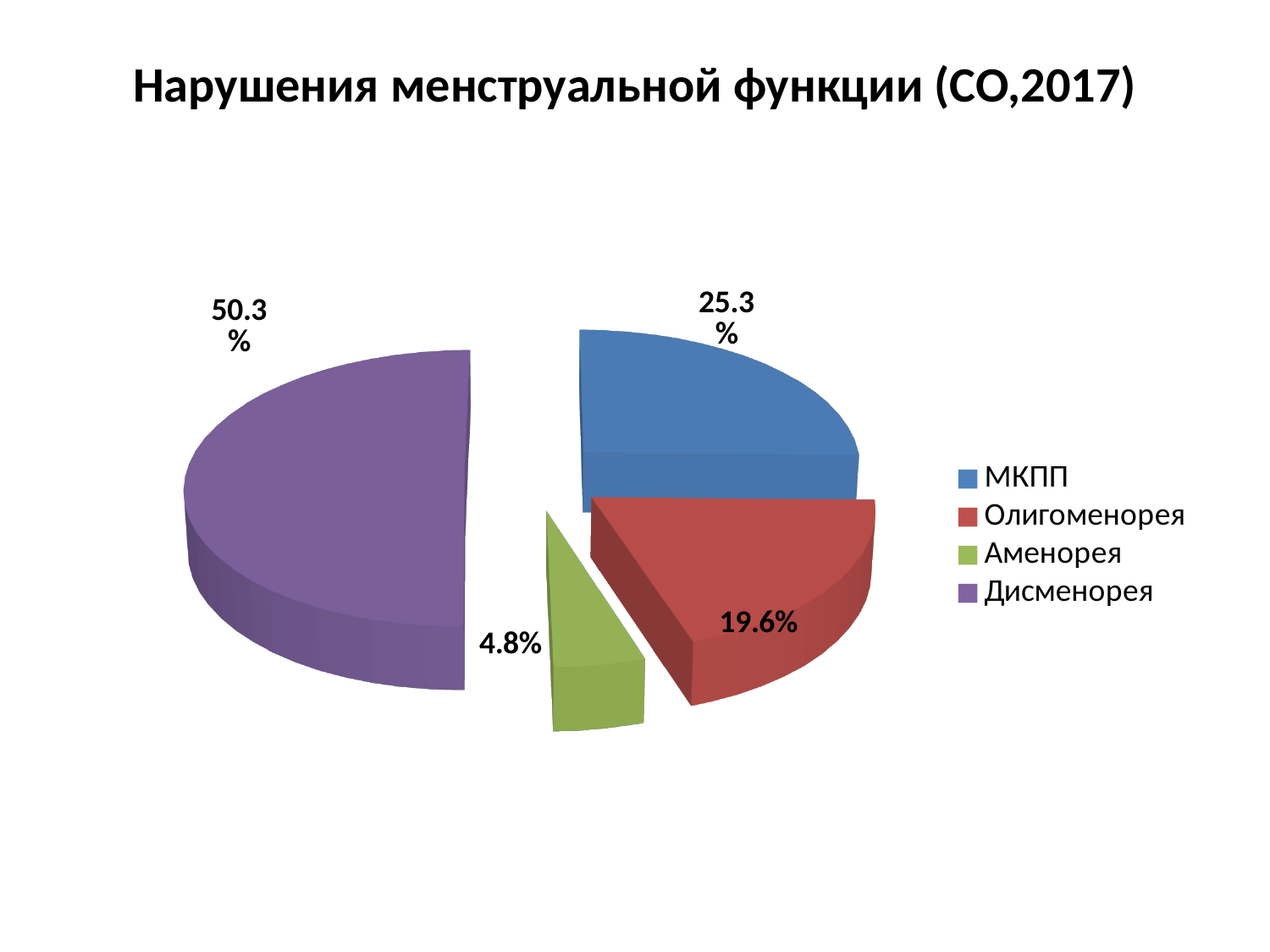
How many categories does the pie chart have? 4 What is the value for Олигоменорея? 19.6% What colour is the slice for Аменорея? green Which is larger, the value for МКПП or the value for Олигоменорея? МКПП What is the value for МКПП? 25.3% What kind of chart is shown on the slide? pie chart Which category has the largest share of the pie? Дисменорея What is the difference between the values for Дисменорея and МКПП? 25% Which category has the smallest share of the pie? Аменорея What is the value for Дисменорея? 50.3% What is the value for Аменорея? 4.8% What is the title of the chart? Нарушения менструальной функции (СО,2017)